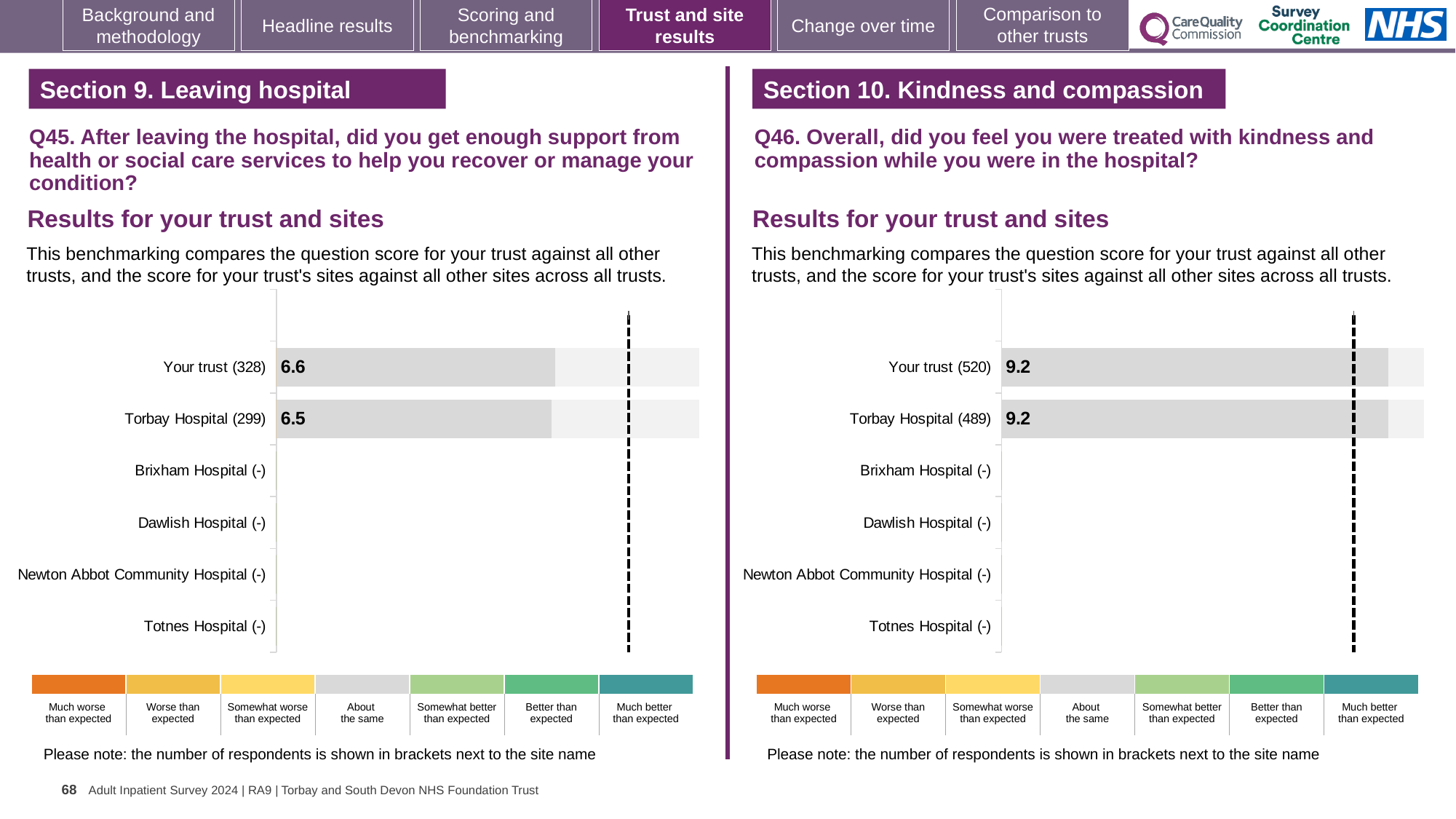
How many site or trust categories are listed on the y axis of the Q45 chart on the left? 6 In the Q45 chart on the left, how many respondents are shown in brackets for Your trust? 328 How many benchmark categories does the colour legend below the Q46 chart on the right list? 7 In the Q45 chart on the left, how many categories have a plotted score rather than a dash (-)? 2 In the Q46 chart on the right, what is the score for Your trust? 9.2 In the Q45 chart on the left, what is the difference between the score for Your trust and the score for Torbay Hospital? 0.1 In the Q45 chart on the left, what is the score for Your trust? 6.6 In the Q46 chart on the right, what is the score for Torbay Hospital? 9.2 In the Q46 chart on the right, what is the difference between the score for Your trust and the score for Torbay Hospital? 0 What kind of chart is the Q46 chart on the right? Bar chart In the Q46 chart on the right, how many respondents are shown in brackets for Torbay Hospital? 489 In the Q45 chart on the left, what is the score for Torbay Hospital? 6.5